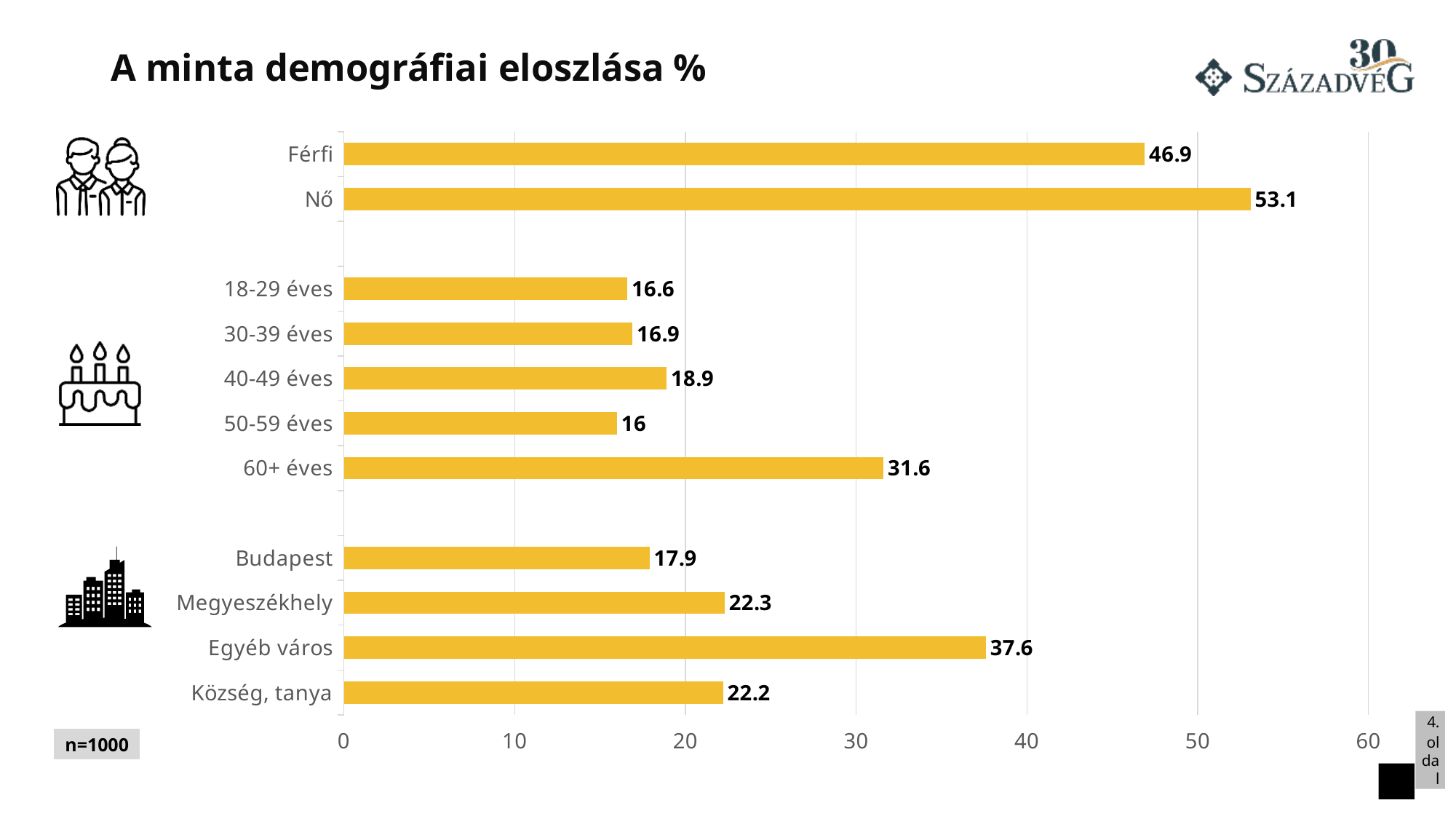
Which category has the lowest value on the chart? 50-59 éves What is the difference between the values for Nő and Férfi? 6.2 What is the value for 60+ éves? 31.6 Which is larger, the value for Budapest or the value for Megyeszékhely? Megyeszékhely What kind of chart is shown on the slide? bar chart What is the title of the chart? A minta demográfiai eloszlása % What is the value for Nő? 53.1 Which category has the highest value on the chart? Nő How many categories are plotted on the chart? 11 Is the value for Egyéb város greater or less than 30? greater What sample size is noted on the slide? n=1000 What is the value for Egyéb város? 37.6